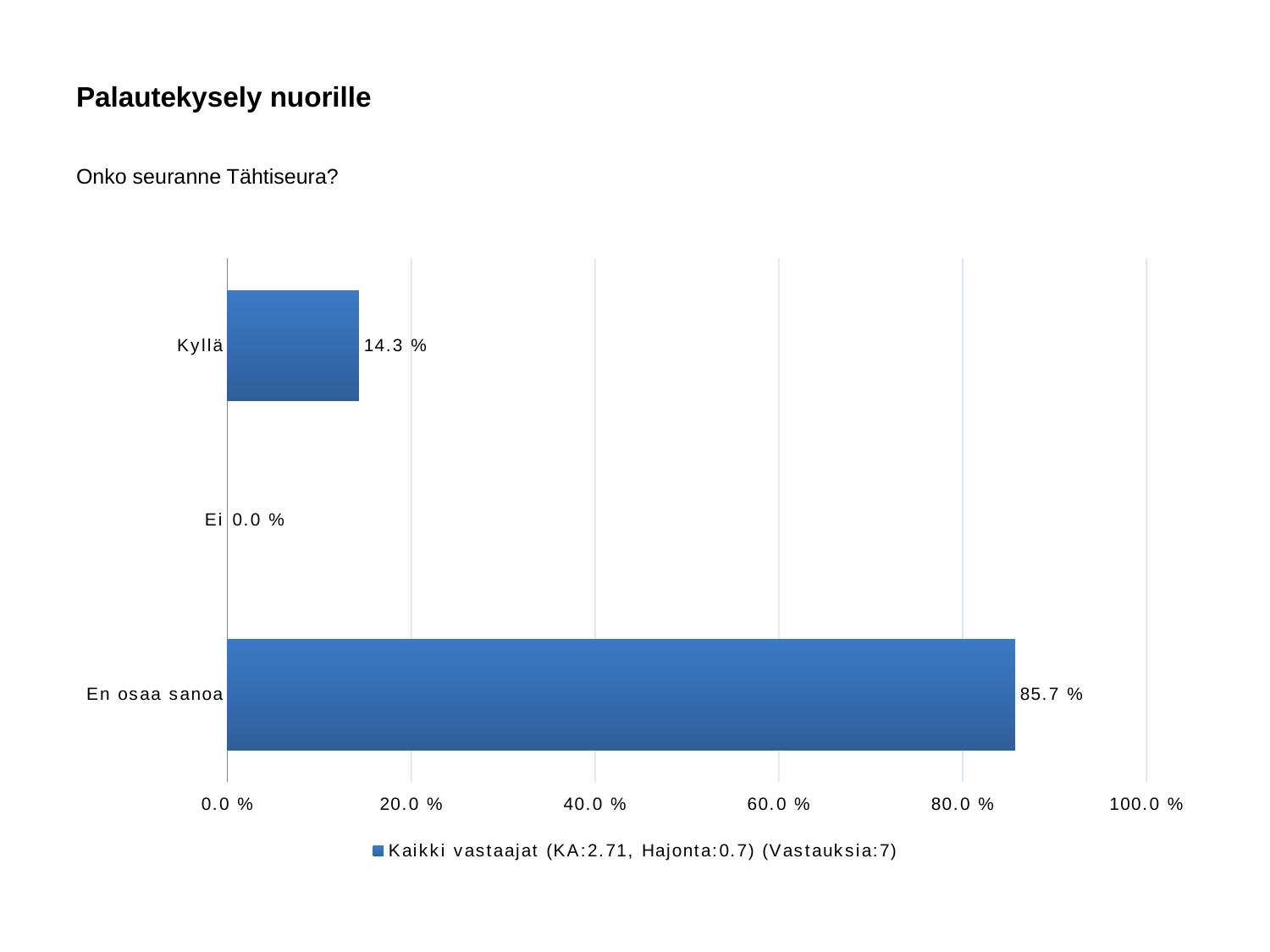
What is the difference between the values for En osaa sanoa and Kyllä? 71.4 % What is the value for En osaa sanoa? 85.7 % How many responses (Vastauksia) does the legend report? 7 Which is larger, the value for Kyllä or the value for En osaa sanoa? En osaa sanoa How many categories are shown on the chart? 3 Which category has the lowest value? Ei Which category has the highest value? En osaa sanoa What is the value for Kyllä? 14.3 % Is the value for Kyllä greater or less than 20.0 %? less What is the value for Ei? 0.0 % What kind of chart is shown on the slide? bar chart Is the value for En osaa sanoa greater or less than 80.0 %? greater